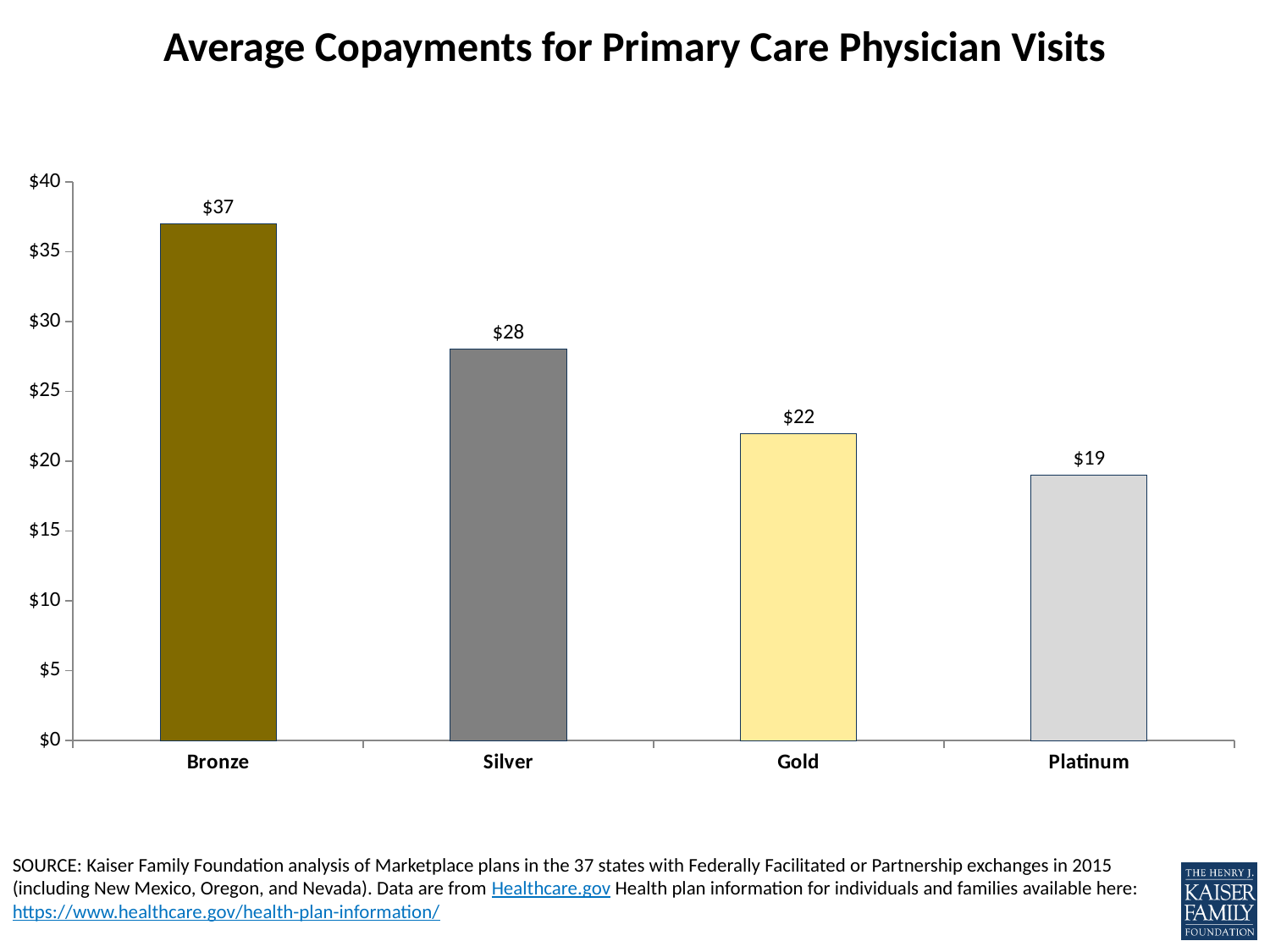
What is the average copayment for a primary care physician visit under Bronze plans? $37 What is the average copayment for Gold plans? $22 Which plan type has the highest average copayment? Bronze How much higher is the average copayment for Bronze plans than for Silver plans? $9 How many plan types are shown on the chart? 4 What is the average copayment for Platinum plans? $19 What kind of chart is shown on the slide? Bar chart What is the difference between the Gold and Platinum average copayments? $3 Which plan type has the lowest average copayment? Platinum Do the average copayments rise or fall moving from Bronze to Platinum? Fall Is the average copayment for Silver plans greater or less than $25? greater Which has a larger average copayment, Silver or Gold? Silver